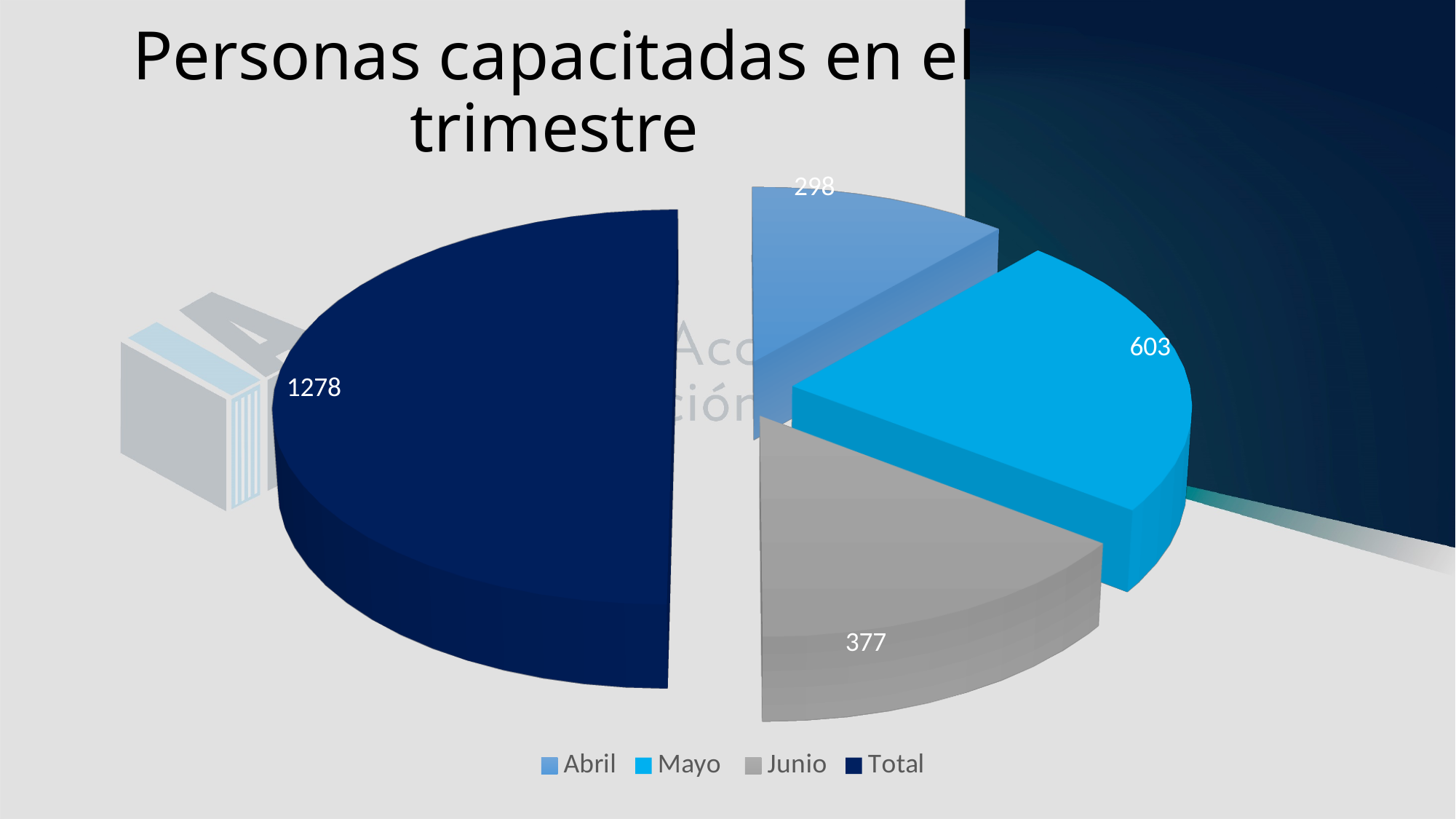
What is the value for Junio? 377 What is the title of the chart? Personas capacitadas en el trimestre Which is larger, the value for Junio or the value for Mayo? Mayo What is the value for Total? 1278 What is the value for Mayo? 603 What share of the whole pie does the Total slice represent? 50% How many entries does the legend list? 4 Which slice has the smallest value? Abril What is the value for Abril? 298 What kind of chart is shown on the slide? Pie chart Which slice has the largest value? Total What is the difference between the values for Mayo and Abril? 305